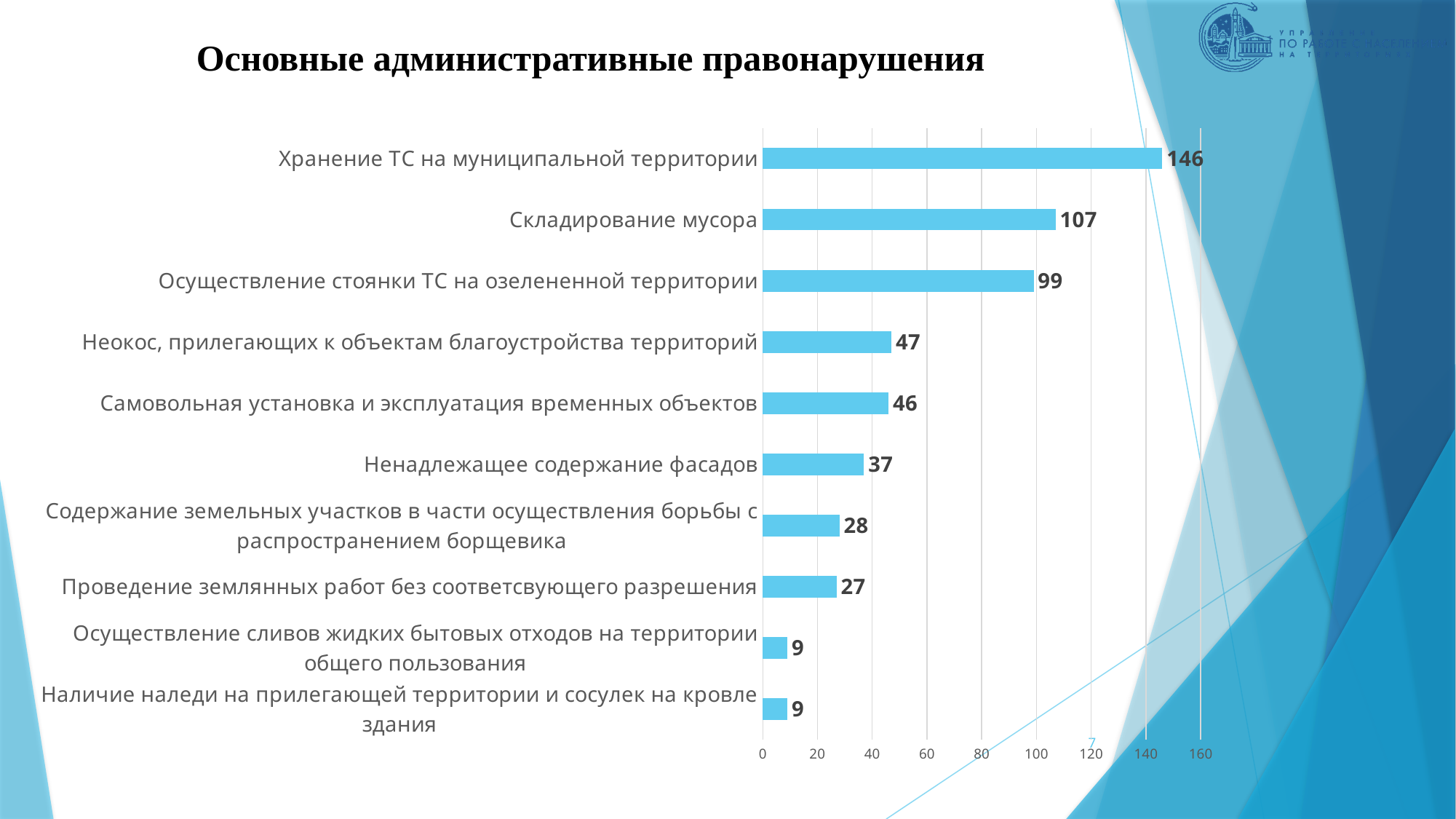
What is the title of the slide? Основные административные правонарушения What is the value for "Ненадлежащее содержание фасадов"? 37 How many categories are shown in the chart? 10 Which is larger: the value for "Складирование мусора" or the value for "Осуществление стоянки ТС на озелененной территории"? Складирование мусора Which category has the highest value? Хранение ТС на муниципальной территории What is the value for "Проведение землянных работ без соответсвующего разрешения"? 27 What is the value for "Складирование мусора"? 107 What is the difference between the values for "Хранение ТС на муниципальной территории" and "Складирование мусора"? 39 What is the value for "Хранение ТС на муниципальной территории"? 146 What is the difference between the values for "Осуществление стоянки ТС на озелененной территории" and "Неокос, прилегающих к объектам благоустройства территорий"? 52 What kind of chart is shown on the slide? bar chart Is the value for "Самовольная установка и эксплуатация временных объектов" greater or less than 40? greater